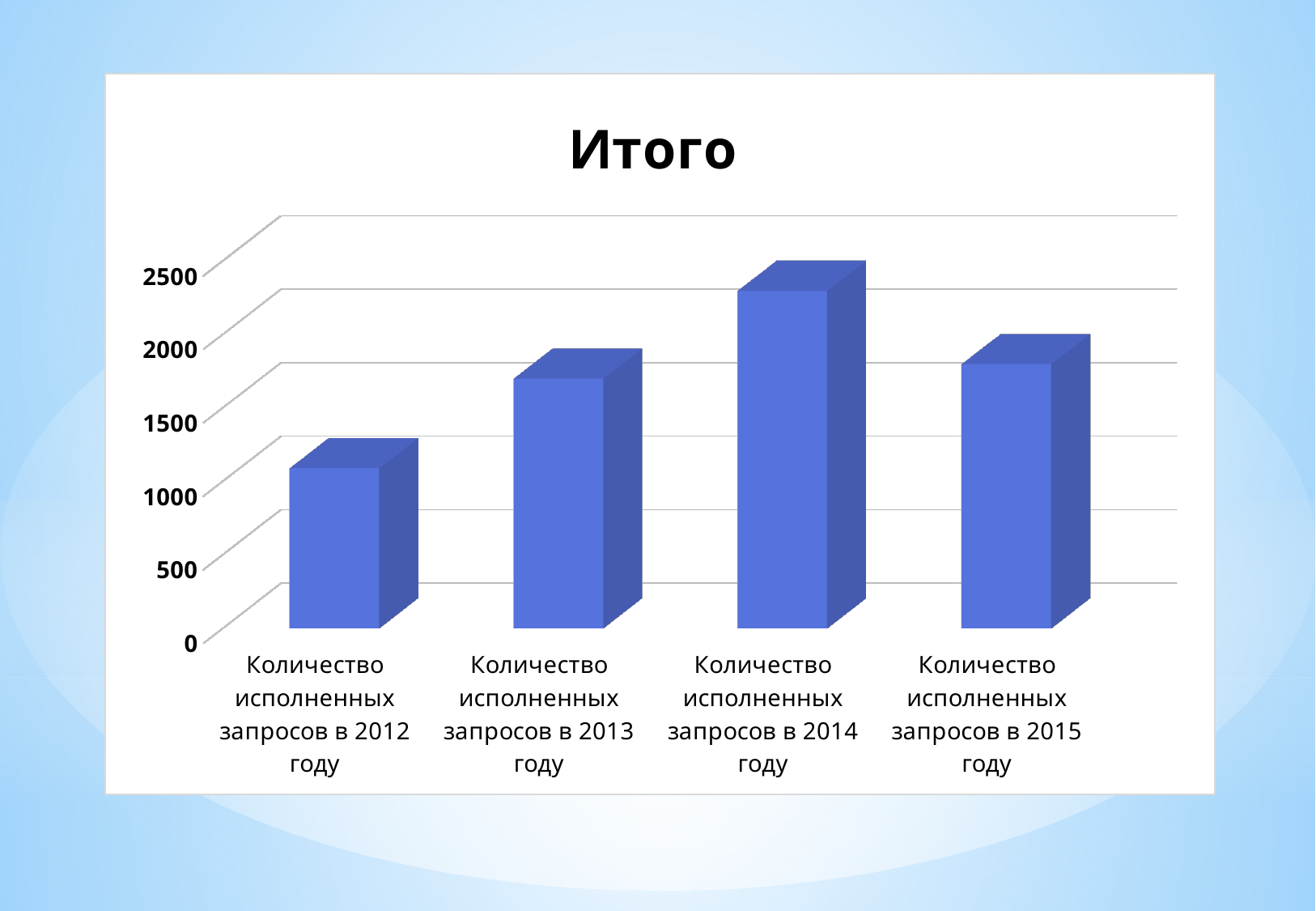
Is the value for Количество исполненных запросов в 2013 году greater or less than 1500? greater How many bars (categories) does the chart show? 4 Is the value for Количество исполненных запросов в 2015 году greater or less than 2000? less Is the value for Количество исполненных запросов в 2012 году greater or less than 1500? less How do the values change from 2012 to 2014? They rise What is the title of the chart? Итого What kind of chart is shown on the slide? Bar chart Which year has the lowest number of completed requests (Количество исполненных запросов)? 2012 Which is larger: the value for 2014 or the value for 2012? 2014 Which year has the highest number of completed requests (Количество исполненных запросов)? 2014